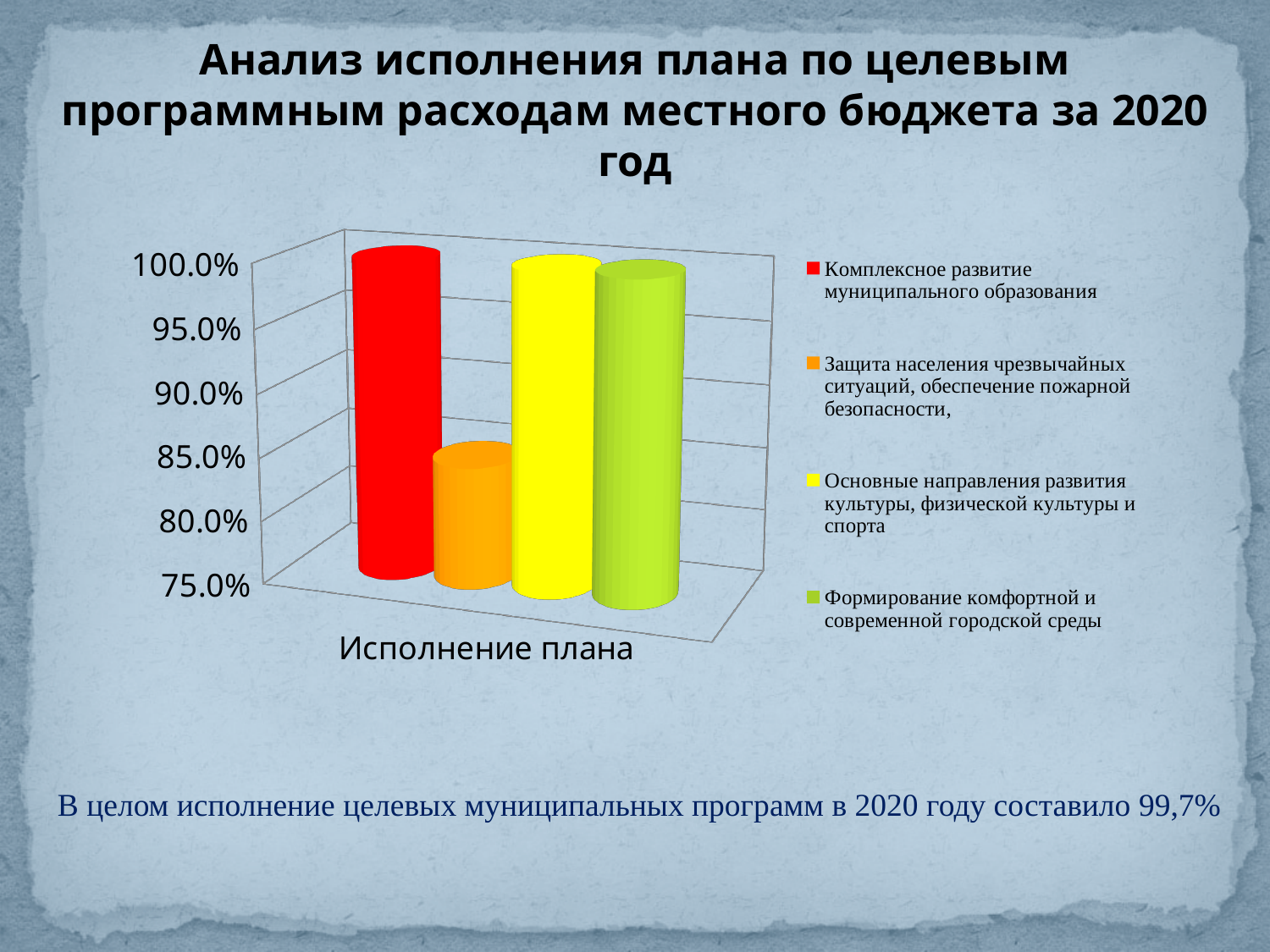
Which is larger: the value for Основные направления развития культуры, физической культуры и спорта or the value for Защита населения чрезвычайных ситуаций, обеспечение пожарной безопасности? Основные направления развития культуры, физической культуры и спорта Which series has the lowest value? Защита населения чрезвычайных ситуаций, обеспечение пожарной безопасности, Is the value for Комплексное развитие муниципального образования greater or less than 95.0%? greater How many series does the legend list? 4 What kind of chart is shown on the slide? bar chart Which series is shown in red? Комплексное развитие муниципального образования How many categories are shown on the x axis? 1 Which is larger: the value for Комплексное развитие муниципального образования or the value for Защита населения чрезвычайных ситуаций, обеспечение пожарной безопасности? Комплексное развитие муниципального образования What is the label of the category on the x axis? Исполнение плана Is the value for Формирование комфортной и современной городской среды greater or less than 95.0%? greater Is the value for Защита населения чрезвычайных ситуаций, обеспечение пожарной безопасности greater or less than 90.0%? less